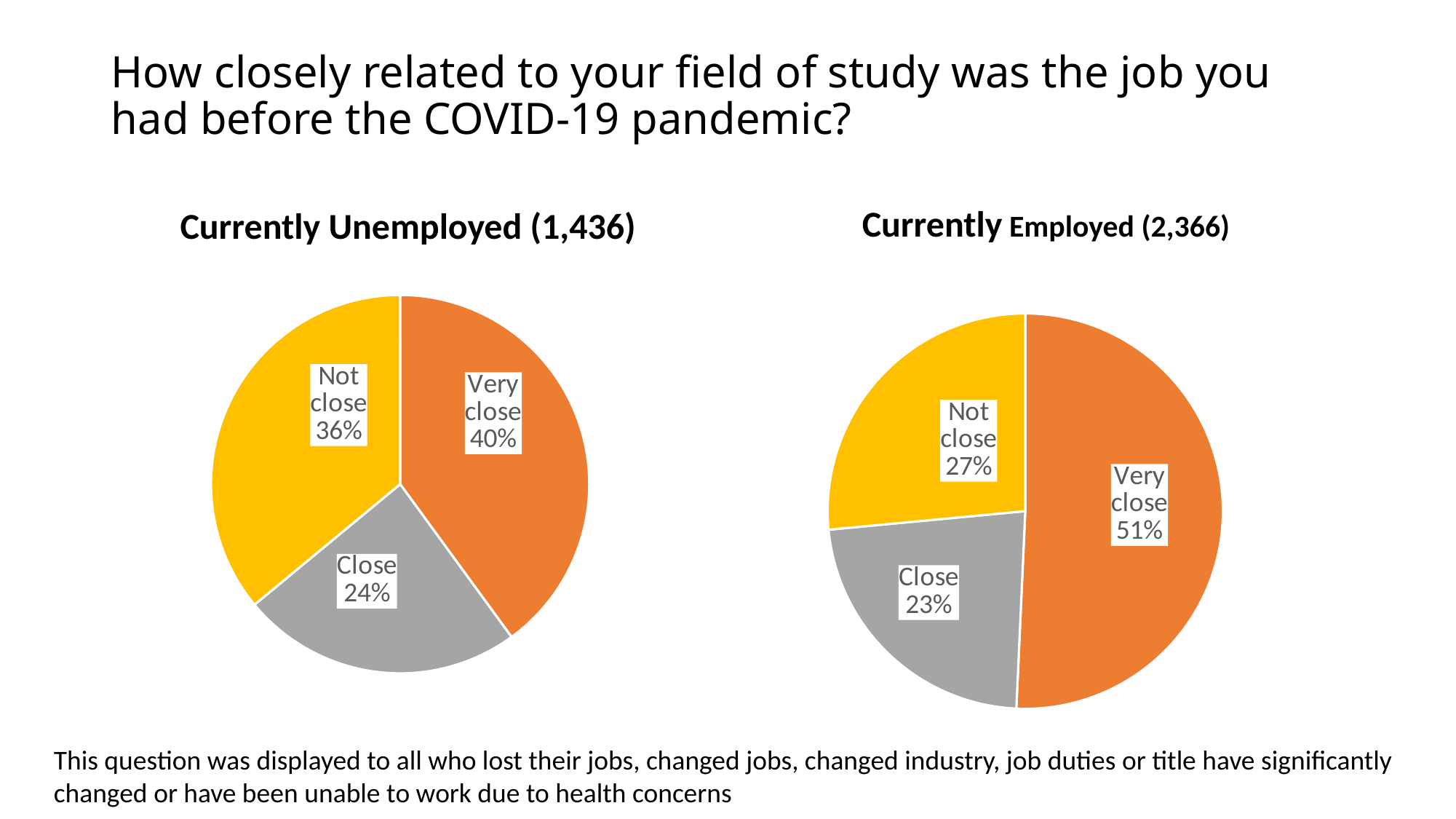
In the Currently Employed pie chart, which category has the largest share? Very close What is the difference between the Very close share in the Currently Employed chart and the Very close share in the Currently Unemployed chart? 11 percentage points In the Currently Employed pie chart, which category has the smallest share? Close In the Currently Employed pie chart, what share of respondents said their job was Not close to their field of study? 27% In the Currently Unemployed pie chart, what share of respondents said their job was Very close to their field of study? 40% What type of chart is used for the Currently Unemployed data? Pie chart Which is larger: the Not close share in the Currently Unemployed chart or the Not close share in the Currently Employed chart? Currently Unemployed In the Currently Employed pie chart, what percentage is shown for Close? 23% How many slices does the Currently Employed pie chart have? 3 In the Currently Unemployed pie chart, what percentage is shown for Close? 24% In the Currently Unemployed pie chart, what is the difference between the Not close share and the Close share? 12 percentage points In the Currently Unemployed pie chart, which category has the smallest share? Close